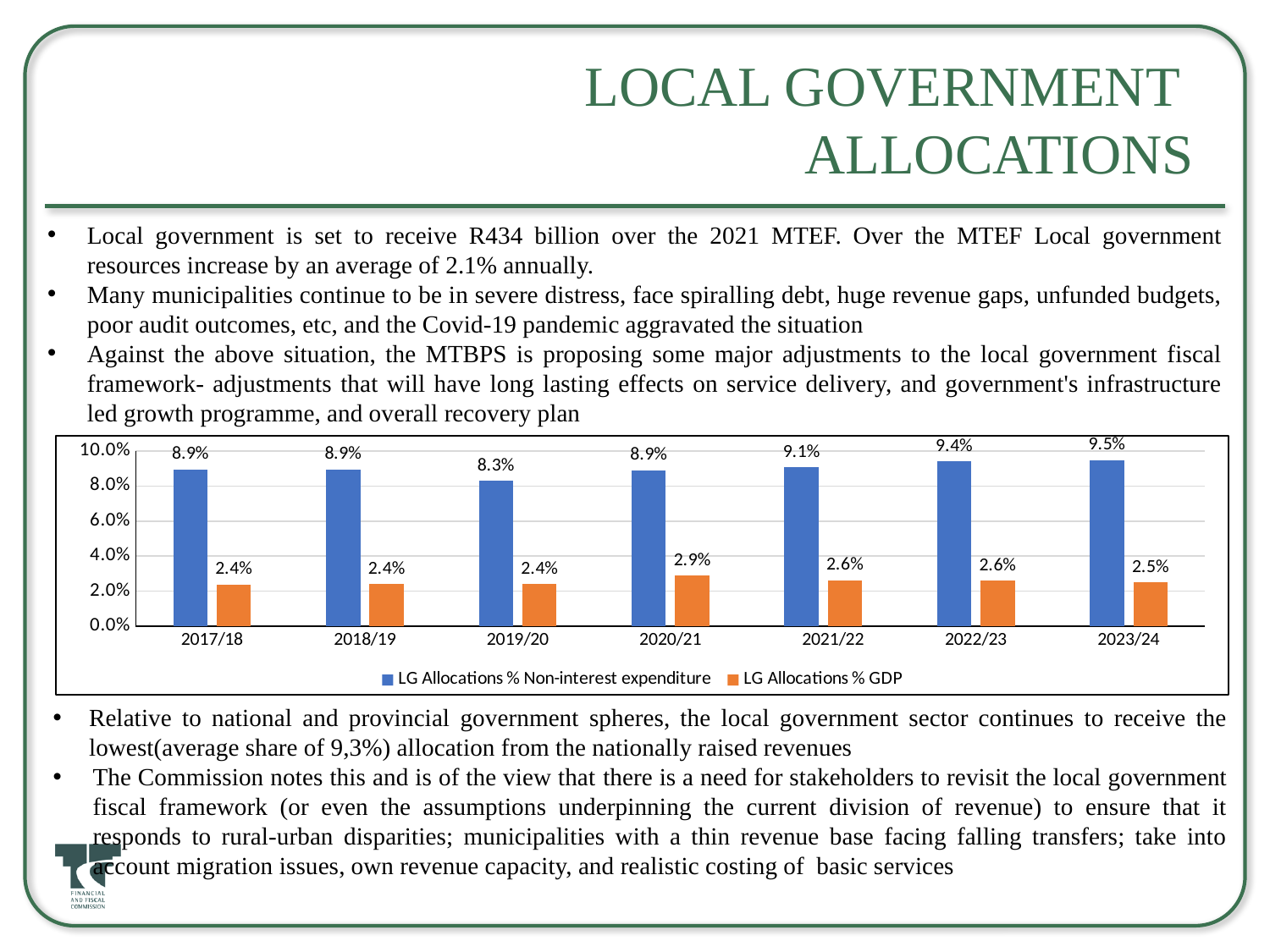
What is the difference between LG Allocations % Non-interest expenditure in 2023/24 and in 2019/20? 1.2% How many years are shown on the x axis of the chart? 7 Which is larger: LG Allocations % GDP in 2020/21 or in 2023/24? 2020/21 What kind of chart is shown on the slide? Bar chart What is the value of LG Allocations % Non-interest expenditure for 2023/24? 9.5% In which year is LG Allocations % Non-interest expenditure the lowest? 2019/20 In which year is LG Allocations % Non-interest expenditure the highest? 2023/24 How many series does the chart's legend list? 2 Which colour represents LG Allocations % GDP in the chart? Orange What is the value of LG Allocations % Non-interest expenditure for 2019/20? 8.3% In which year is LG Allocations % GDP the highest? 2020/21 What is the value of LG Allocations % GDP for 2020/21? 2.9%